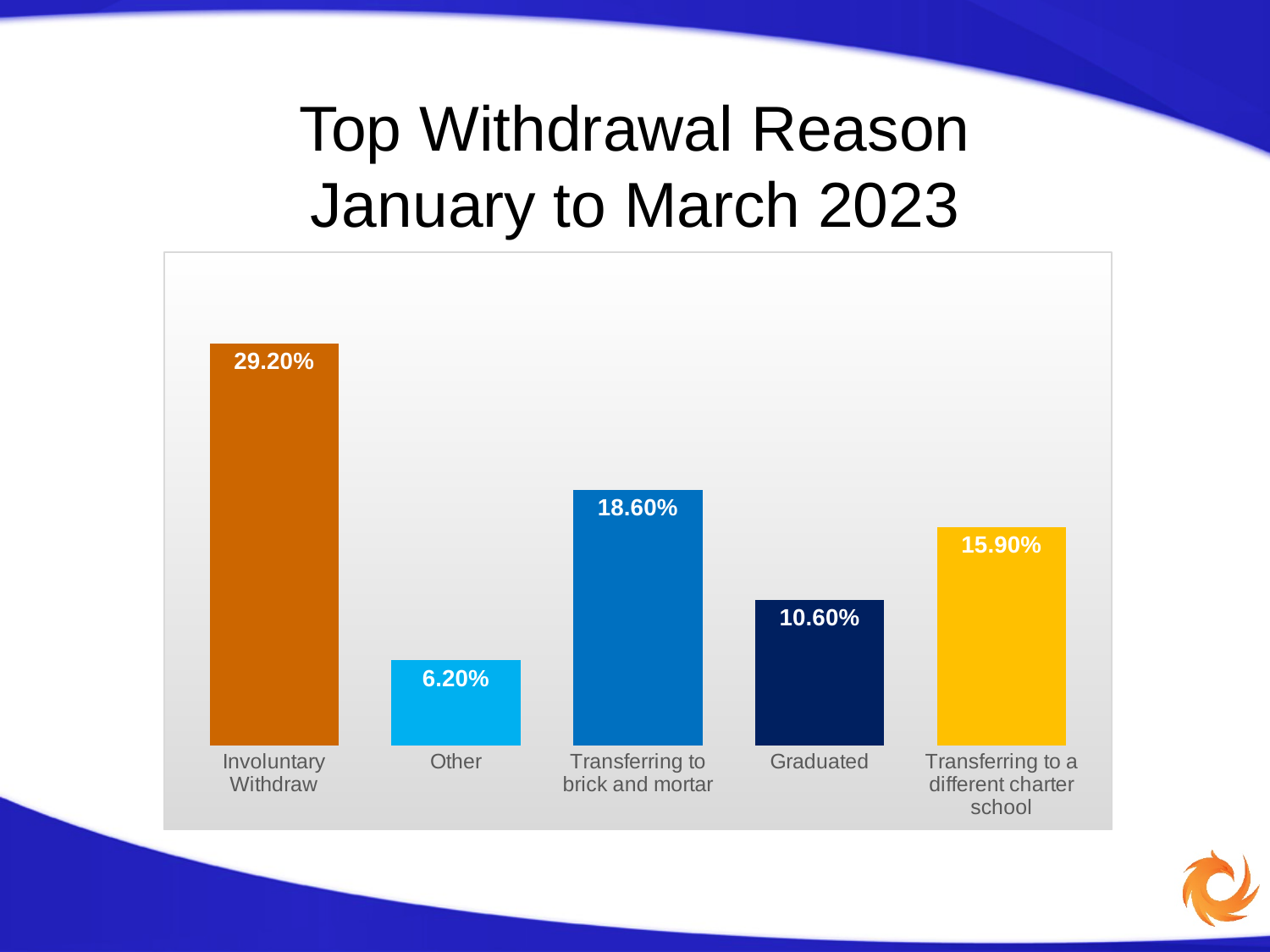
What is the title of the slide? Top Withdrawal Reason January to March 2023 Which withdrawal reason has the lowest value? Other Which withdrawal reason has the highest value? Involuntary Withdraw What is the value for Transferring to a different charter school? 15.90% What is the value for Other? 6.20% What is the value for Graduated? 10.60% How many withdrawal reasons are shown in the chart? 5 Which is larger, the value for Graduated or the value for Transferring to a different charter school? Transferring to a different charter school What is the difference between the values for Involuntary Withdraw and Transferring to brick and mortar? 10.60% What is the value for Transferring to brick and mortar? 18.60% What is the value for Involuntary Withdraw? 29.20% What kind of chart is shown on the slide? Bar chart